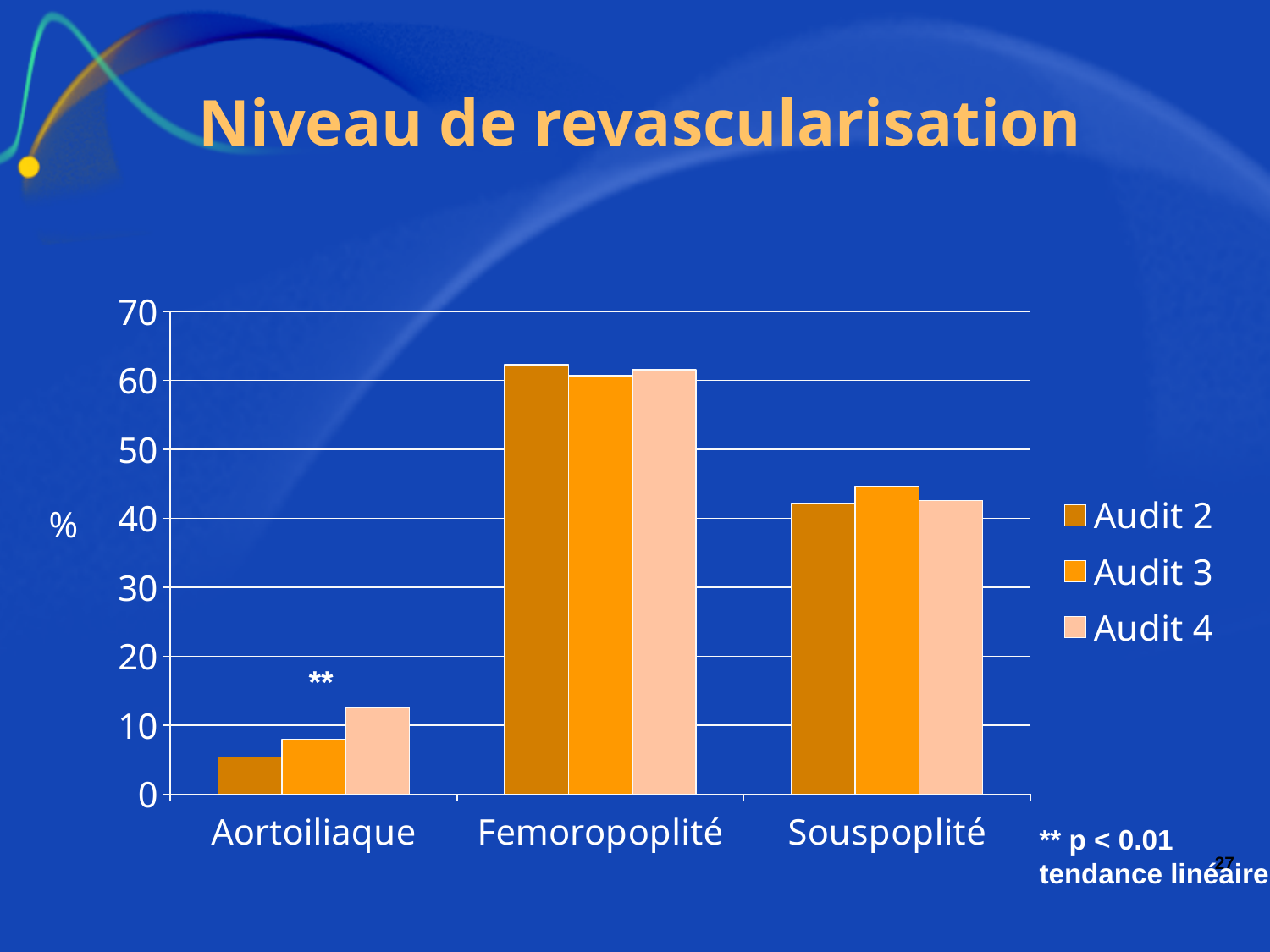
Is the Audit 3 value for Souspoplité greater or less than 40? greater What kind of chart is shown on the slide? bar chart What is the title of the chart on the slide? Niveau de revascularisation For Aortoiliaque, do the values rise or fall from Audit 2 to Audit 4? rise For Aortoiliaque, which is larger: the Audit 2 value or the Audit 4 value? Audit 4 Is the Audit 4 value for Aortoiliaque greater or less than 10? greater Is the Audit 2 value for Femoropoplité greater or less than 60? greater Which category has the lowest Audit 4 value? Aortoiliaque How many categories are shown on the x axis of the chart? 3 Which category has the highest Audit 2 value? Femoropoplité How many series does the legend list? 3